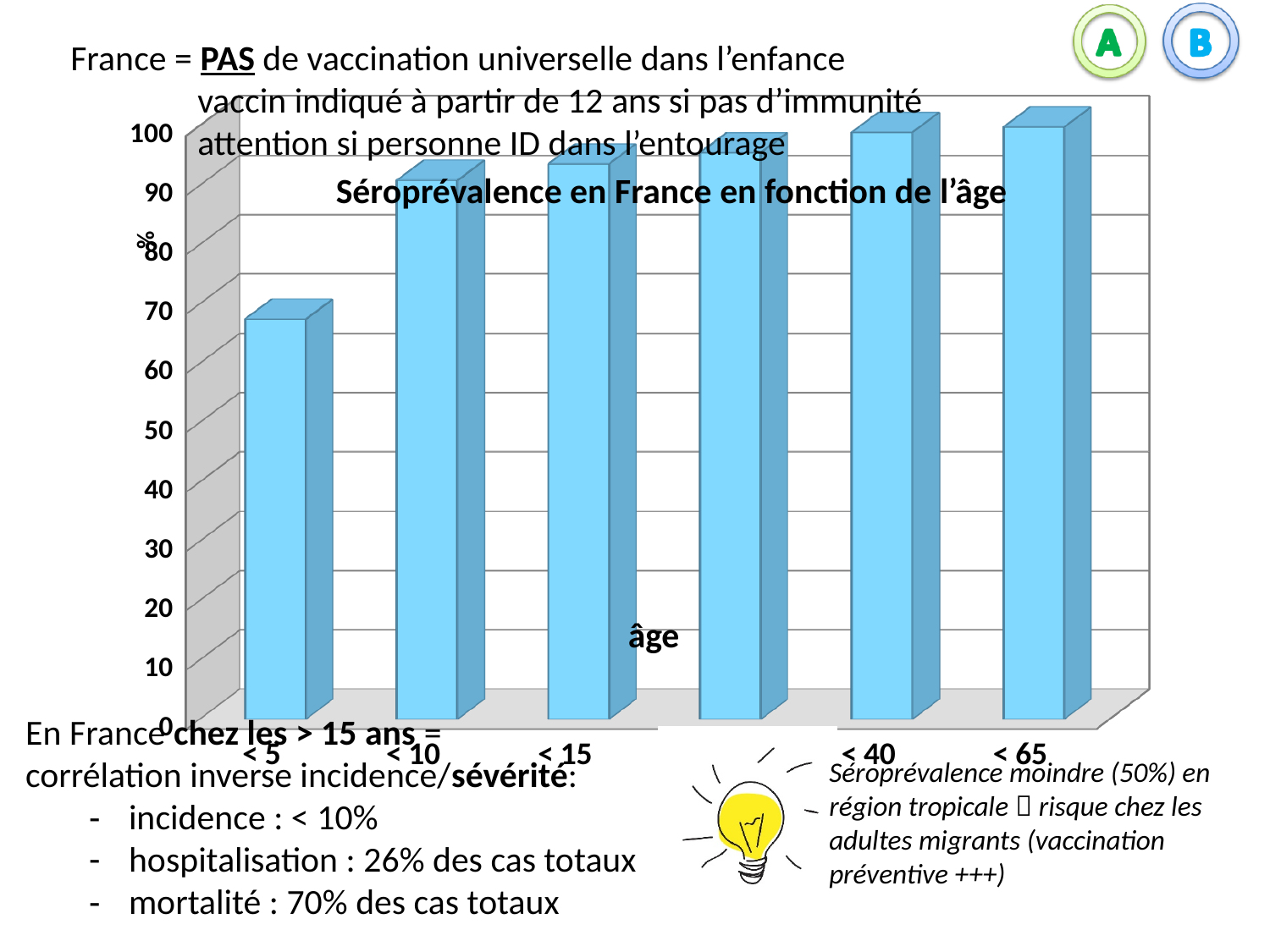
What is the title of the chart? Séroprévalence en France en fonction de l'âge What kind of chart is shown on the slide? bar chart Is the value for the < 5 age group greater or less than 60? greater Which is larger, the value for < 5 or the value for < 10? < 10 Which age category has the lowest seroprevalence? < 5 How many bars are plotted in the chart? 6 What label is given to the x axis of the chart? âge Do the values rise or fall as age increases along the x axis? rise Is the value for the < 10 age group greater or less than 80? greater Which is larger, the value for < 5 or the value for < 65? < 65 Is the value for the < 65 age group greater or less than 90? greater